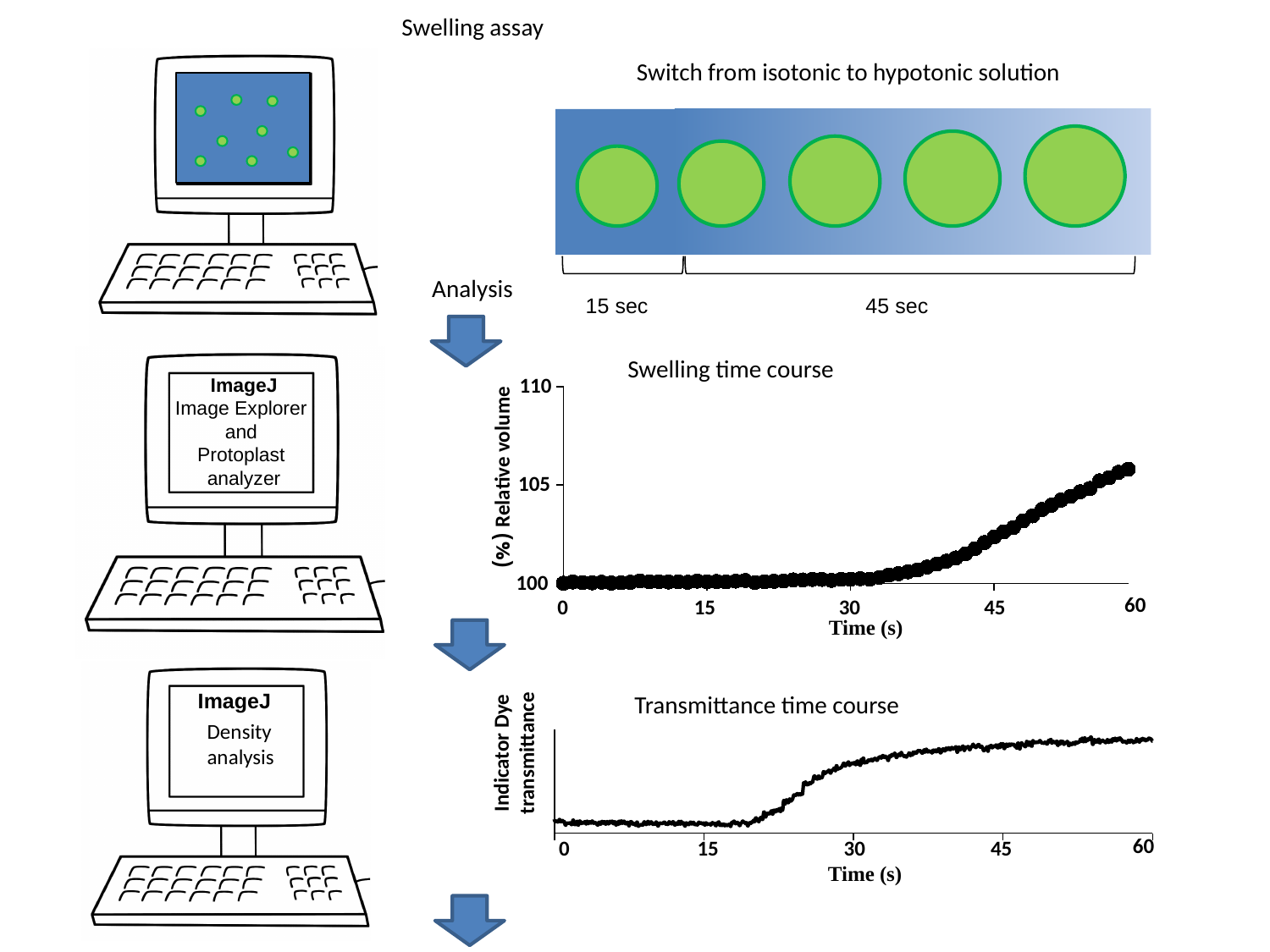
In the Swelling time course chart, what is the label of the y axis? (%) Relative volume In the Transmittance time course chart, is the transmittance at 45 s higher or lower than at 0 s? higher In the Swelling time course chart, is the relative volume at 60 s greater or less than 105? greater In the Transmittance time course chart, does the indicator dye transmittance rise or fall between 15 s and 30 s? rise In the Swelling time course chart, is the relative volume at 45 s greater or less than 105? less In the Swelling time course chart, what is the highest value shown on the y axis? 110 In the Swelling time course chart, what is the last tick value on the x axis? 60 In the Swelling time course chart, is the relative volume at 15 s greater or less than 105? less In the Swelling time course chart, is the relative volume at 60 s larger or smaller than at 0 s? larger In the Swelling time course chart, what is the label of the x axis? Time (s) What kind of chart is the Transmittance time course chart? line chart In the Swelling time course chart, does the relative volume rise or fall as time increases from 30 s to 60 s? rise